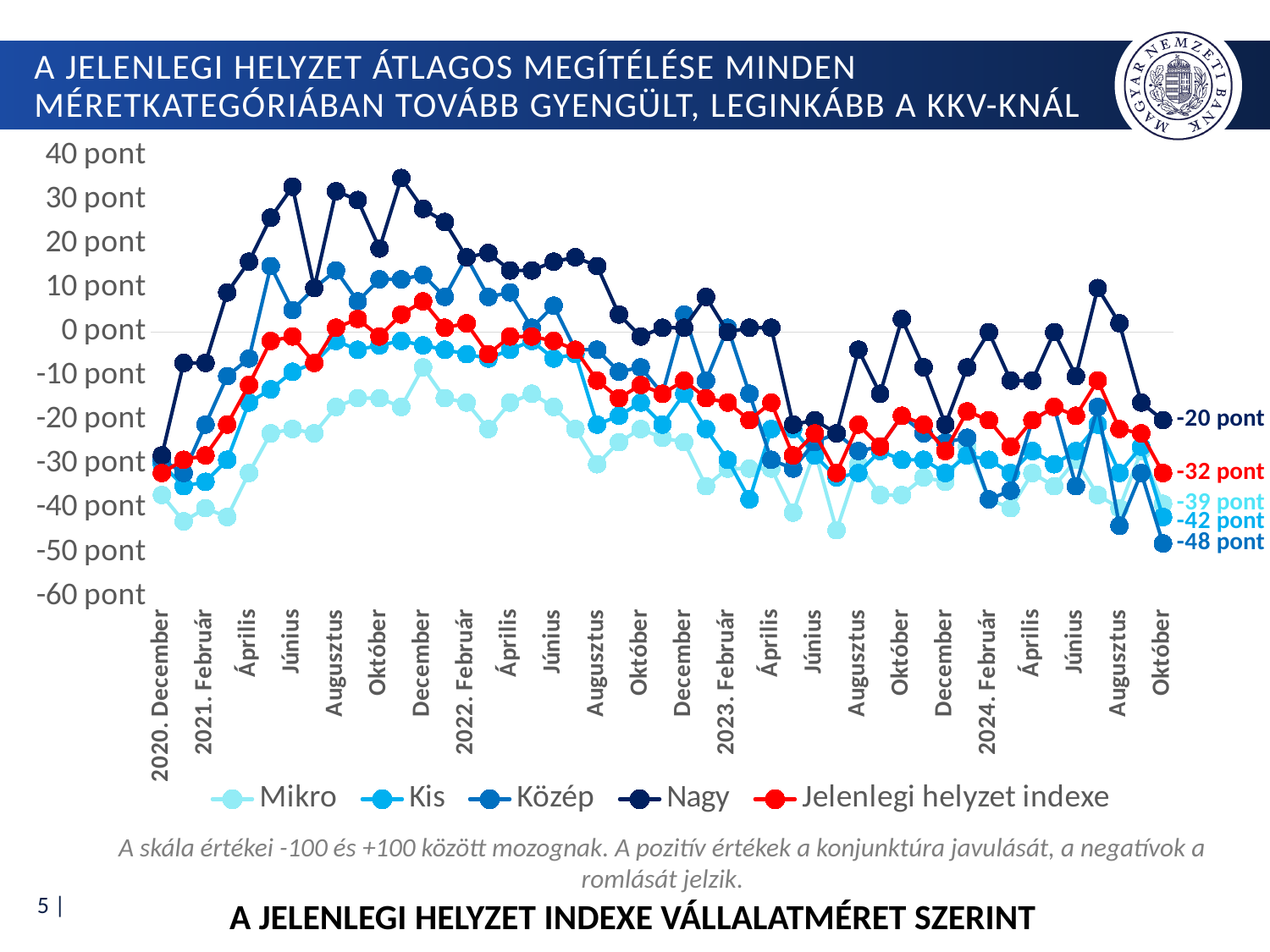
Which series has the highest value at 2024 Október? Nagy What is the value of the Kis series at 2024 Október? -42 pont Is the highest value reached by the Nagy series greater or less than 30 pont? greater At 2024 Október, which is larger: the Mikro value or the Kis value? Mikro What is the value of the Nagy series at 2024 Október, as labelled at the end of the line? -20 pont What is the value of the Mikro series at 2024 Október? -39 pont What kind of chart is shown on the slide? Line chart Which series has the lowest value at 2024 Október? Közép What is the difference between the Nagy and Közép values at 2024 Október? 28 pont What is the value of the Jelenlegi helyzet indexe series at 2024 Október? -32 pont How many series does the legend list? 5 What is the value of the Közép series at 2024 Október? -48 pont